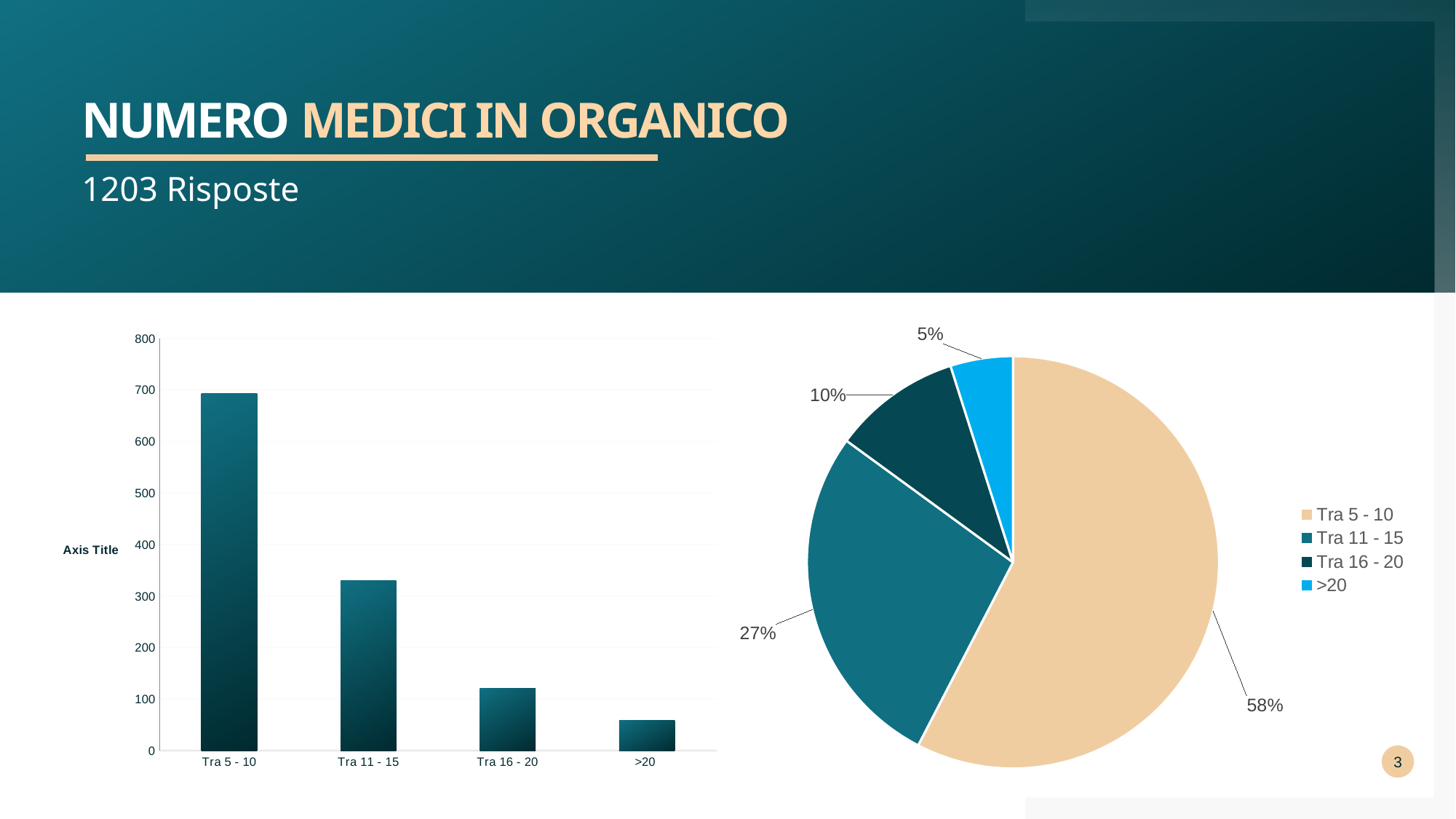
In the bar chart on the left, is the value for Tra 5 - 10 greater or less than 600? greater In the bar chart on the left, how many categories are shown on the x axis? 4 In the bar chart on the left, is the value for >20 greater or less than 100? less In the bar chart on the left, which category has the lowest bar? >20 What kind of chart is the chart on the right of the slide? pie chart What kind of chart is the chart on the left of the slide? bar chart In the bar chart on the left, is the value for Tra 11 - 15 greater or less than 400? less In the bar chart on the left, which category has the highest bar? Tra 5 - 10 In the pie chart on the right, what share does the Tra 5 - 10 slice have? 58% In the pie chart on the right, what share does the Tra 16 - 20 slice have? 10% In the pie chart on the right, how many entries does the legend list? 4 In the bar chart on the left, do the bar values rise or fall from left to right along the x axis? fall